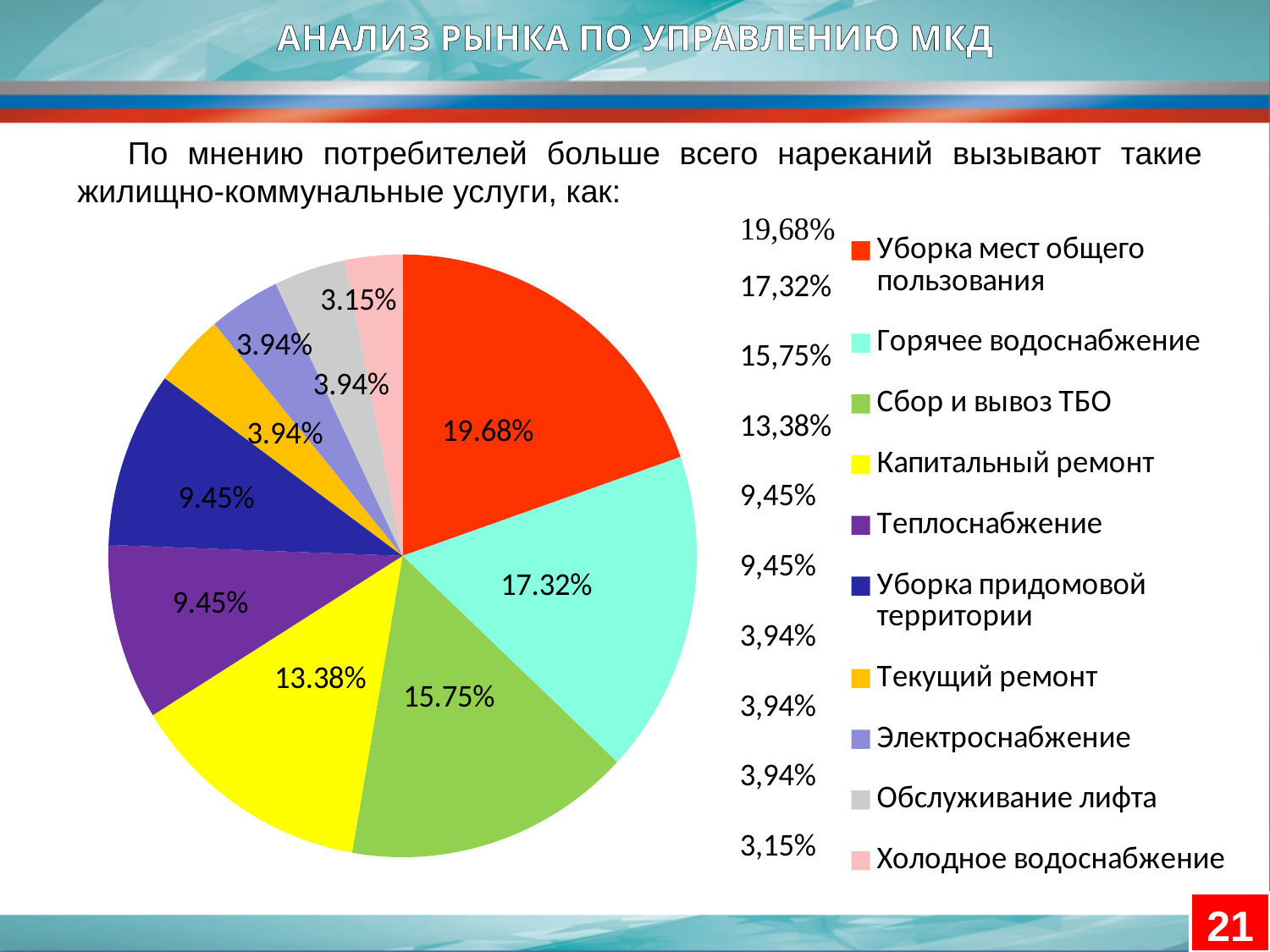
What is the difference between the shares of "Уборка мест общего пользования" and "Горячее водоснабжение"? 2.36% What is the value for "Капитальный ремонт"? 13.38% What kind of chart is shown on the slide? pie chart Which is larger, the share for "Сбор и вывоз ТБО" or the share for "Капитальный ремонт"? Сбор и вывоз ТБО What is the value for "Холодное водоснабжение"? 3.15% What share of the pie does "Уборка мест общего пользования" have? 19.68% How many categories does the pie chart have? 10 Which category has the largest share of the pie? Уборка мест общего пользования What is the value for "Горячее водоснабжение"? 17.32% Which category has the smallest share of the pie? Холодное водоснабжение What colour is the slice for "Капитальный ремонт"? yellow How many entries does the legend list? 10